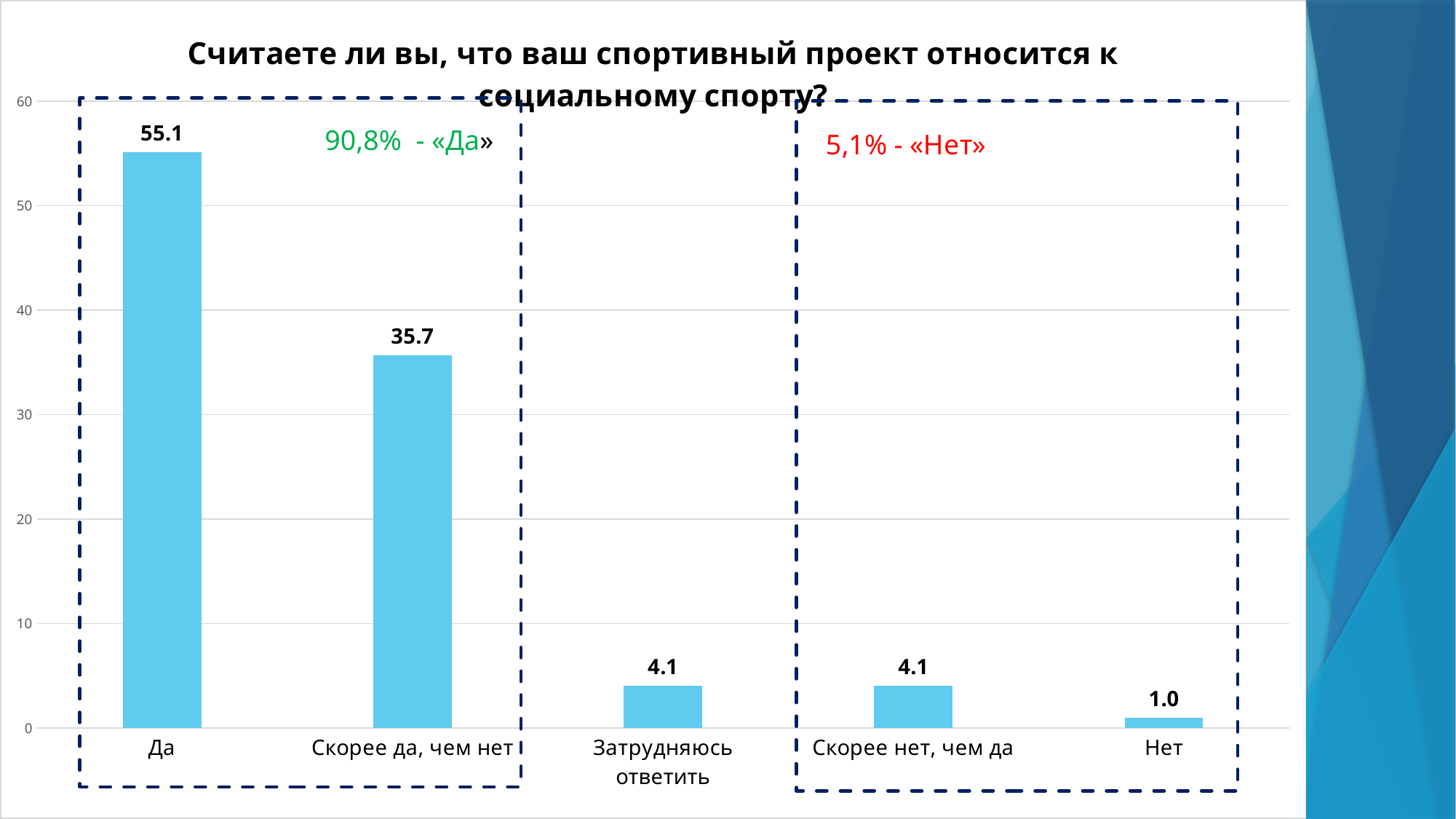
Which category has the highest value? Да What is the value for «Затрудняюсь ответить»? 4.1 What is the value for «Нет»? 1.0 What percentage is shown in green text inside the left dashed box? 90,8% What is the value for «Скорее да, чем нет»? 35.7 What is the value for «Да»? 55.1 Which is larger, the value for «Скорее да, чем нет» or the value for «Скорее нет, чем да»? Скорее да, чем нет Which category has the lowest value? Нет What is the difference between the values for «Да» and «Скорее да, чем нет»? 19.4 How many categories are shown on the x axis? 5 Is the value for «Да» greater or less than 50? greater What kind of chart is shown on the slide? bar chart